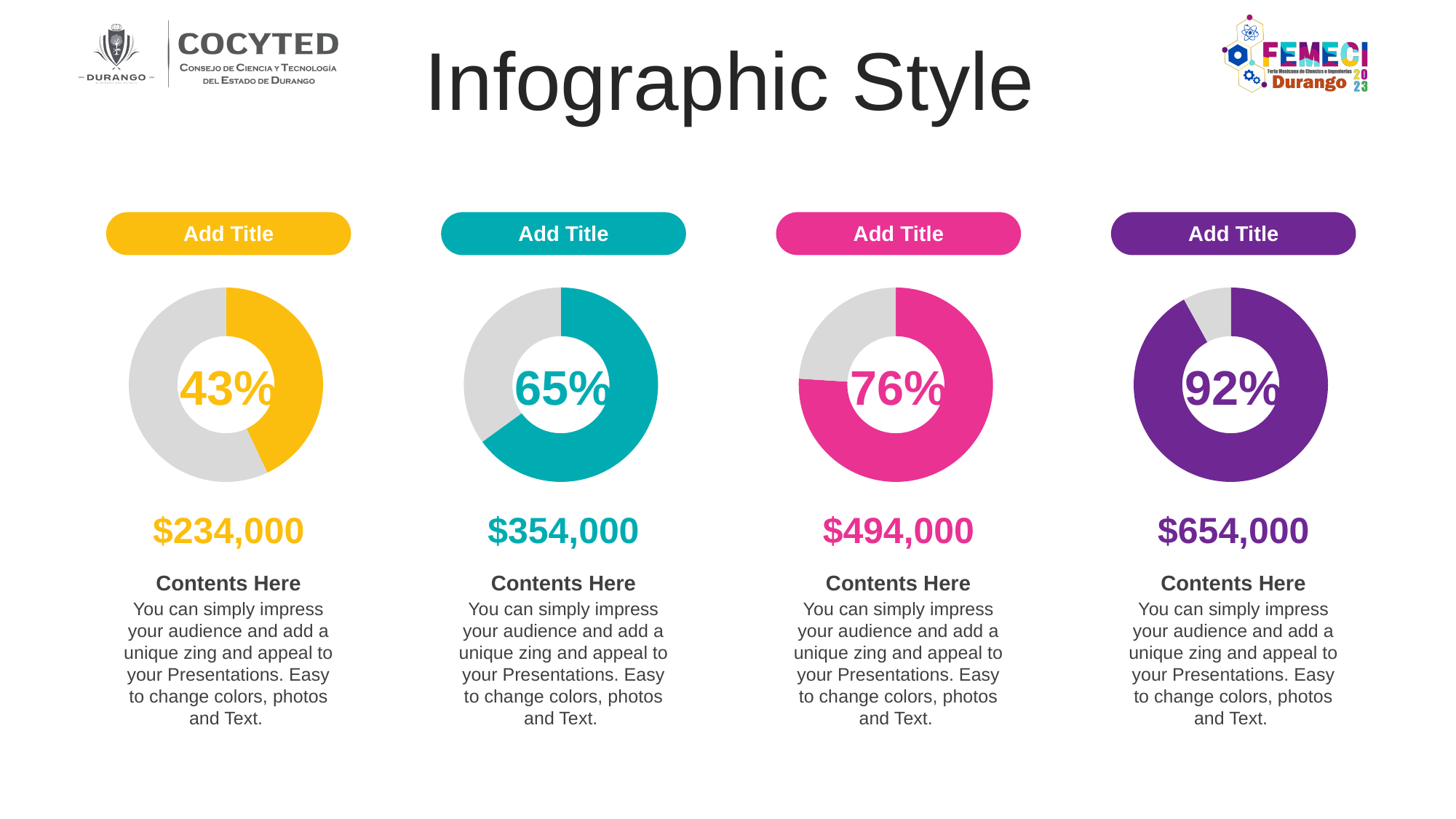
What dollar value is printed below the rightmost (purple) donut chart? $654,000 What kind of chart is used for each of the four figures on the slide? Donut chart What percentage is shown in the second donut chart from the left (teal)? 65% What is the difference between the percentage in the rightmost (purple) donut chart and the leftmost (yellow) donut chart? 49% Which donut chart shows the highest percentage? The rightmost (purple) chart, 92% What percentage is shown in the leftmost (yellow) donut chart? 43% Which is larger: the percentage in the teal donut chart or the pink donut chart? The pink donut chart (76%) What dollar value is printed below the leftmost (yellow) donut chart? $234,000 How many donut charts are on the slide? 4 What percentage is shown in the rightmost (purple) donut chart? 92% What percentage is shown in the third donut chart from the left (pink)? 76% Which donut chart shows the lowest percentage? The leftmost (yellow) chart, 43%